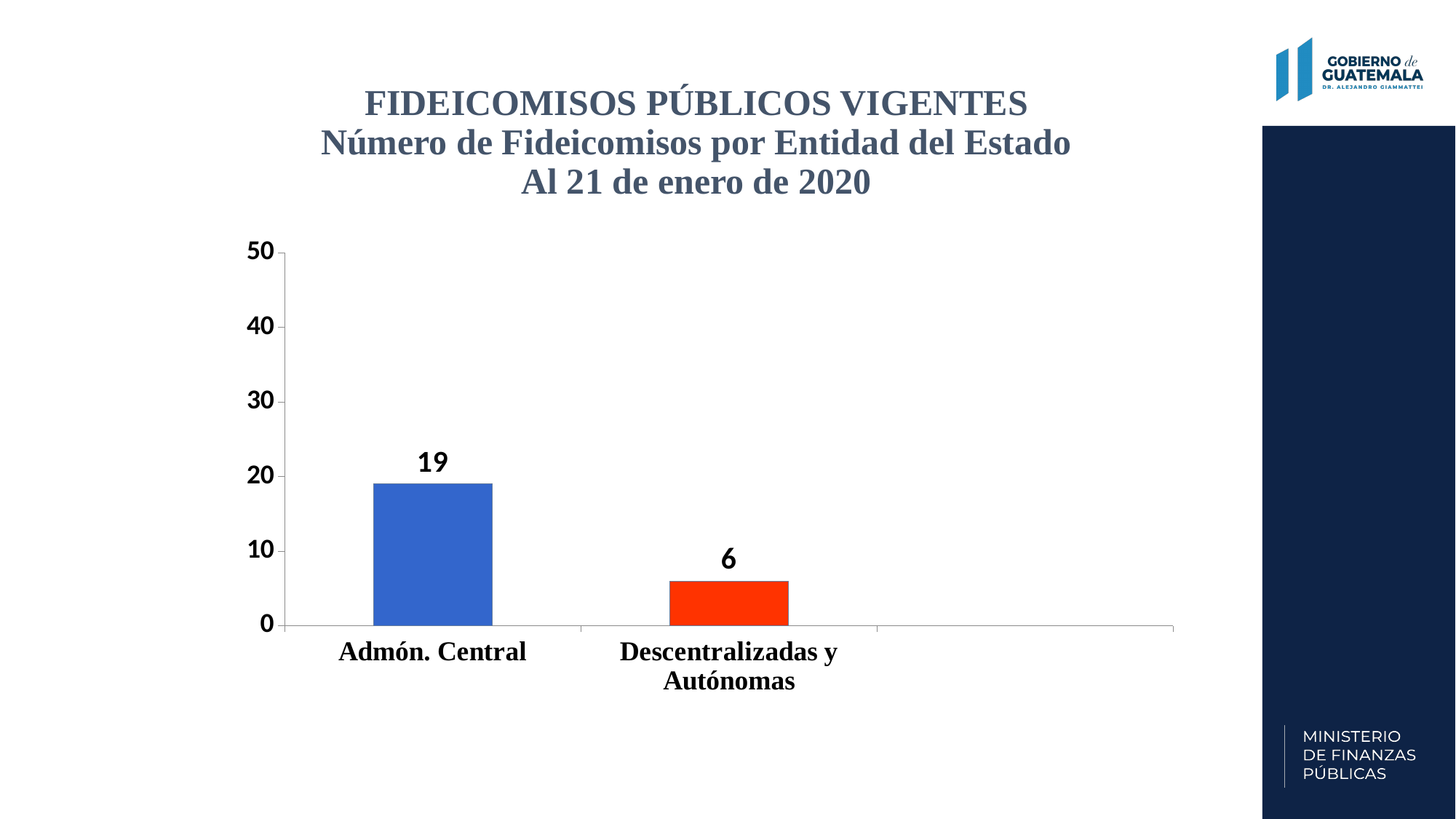
What colour is the bar for Descentralizadas y Autónomas? Red How many categories are shown in the chart? 2 Is the value for Admón. Central greater or less than 20? less Is the value for Descentralizadas y Autónomas greater or less than 10? less What is the value for Descentralizadas y Autónomas? 6 Which category has the highest value? Admón. Central Which is larger, the value for Admón. Central or the value for Descentralizadas y Autónomas? Admón. Central Which category has the lowest value? Descentralizadas y Autónomas What is the highest value shown on the vertical axis? 50 What is the difference between the values for Admón. Central and Descentralizadas y Autónomas? 13 What is the value for Admón. Central? 19 What kind of chart is shown on the slide? Bar chart